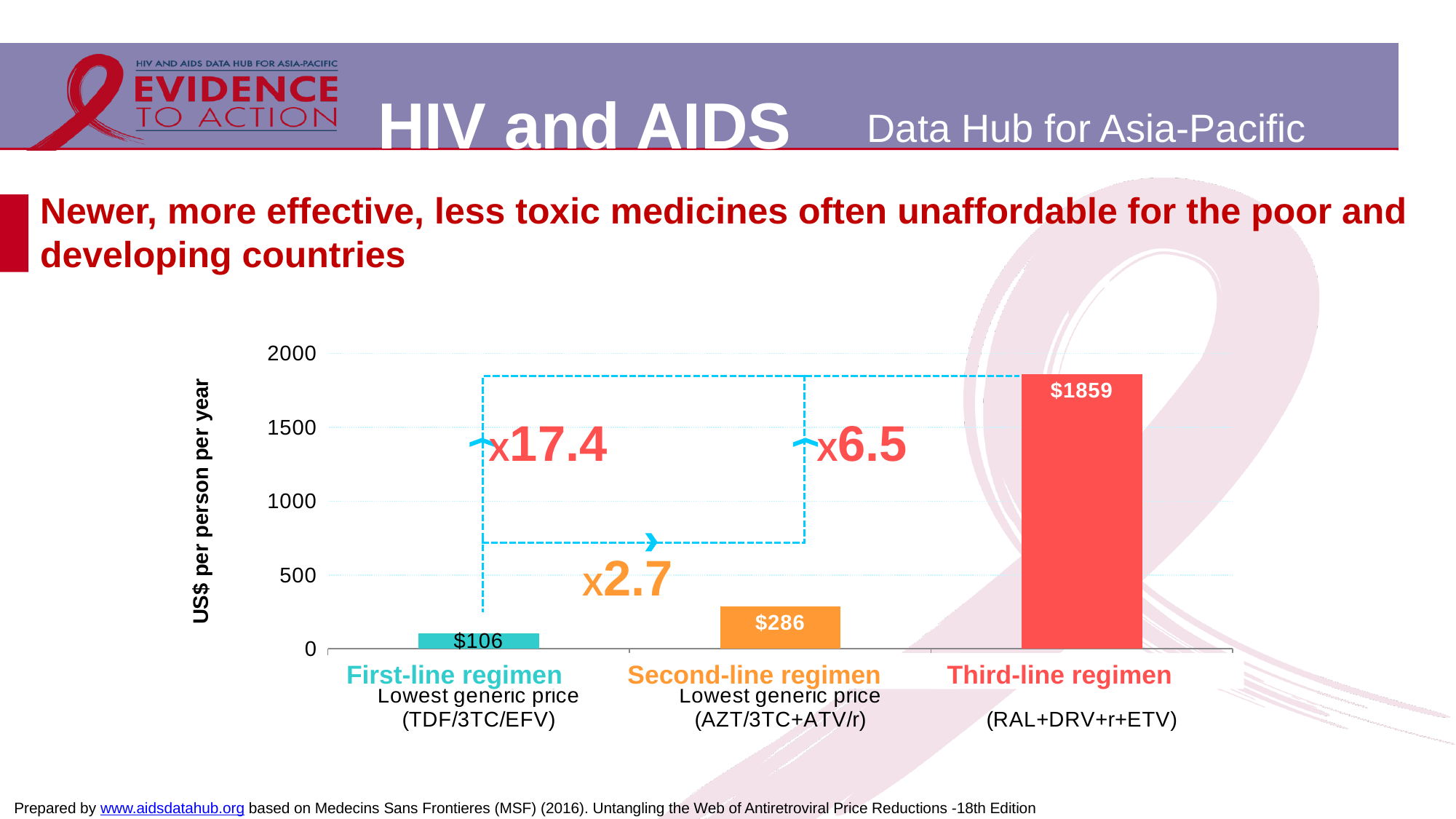
What is the label of the y axis? US$ per person per year What is the value for the Third-line regimen? $1859 How many regimens are shown on the chart? 3 Which regimen has the highest price? Third-line regimen What kind of chart is shown? bar chart Which is larger, the Second-line regimen or the First-line regimen? Second-line regimen What is the difference between the Second-line regimen and the First-line regimen? $180 What is the value for the First-line regimen? $106 What is the value for the Second-line regimen? $286 Which regimen has the lowest price? First-line regimen What is the difference between the Third-line regimen and the First-line regimen? $1753 Is the value for the Third-line regimen greater or less than 1500? greater